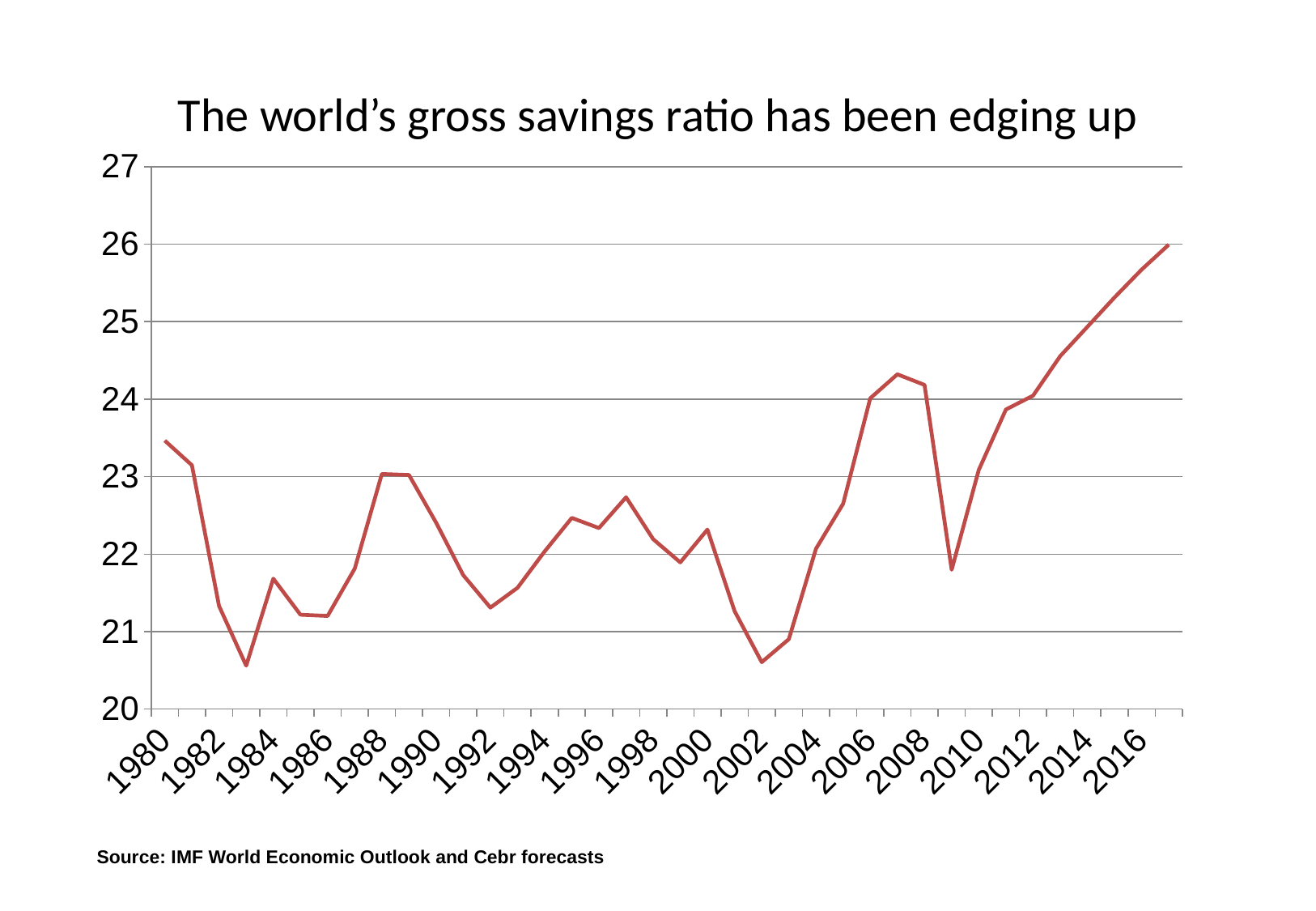
What kind of chart is shown on the slide? line chart Does the gross savings ratio rise or fall between 1980 and 1982? fall Is the value for 1980 greater or less than 23? greater How many lines (series) are plotted on the chart? 1 Is the value for 1992 greater or less than 22? less What is the title of the chart? The world's gross savings ratio has been edging up Is the value for 2010 greater or less than 22? greater Which year has a higher value, 1980 or 2016? 2016 Does the gross savings ratio rise or fall between 2010 and 2016? rise Which year has a higher value, 2002 or 2008? 2008